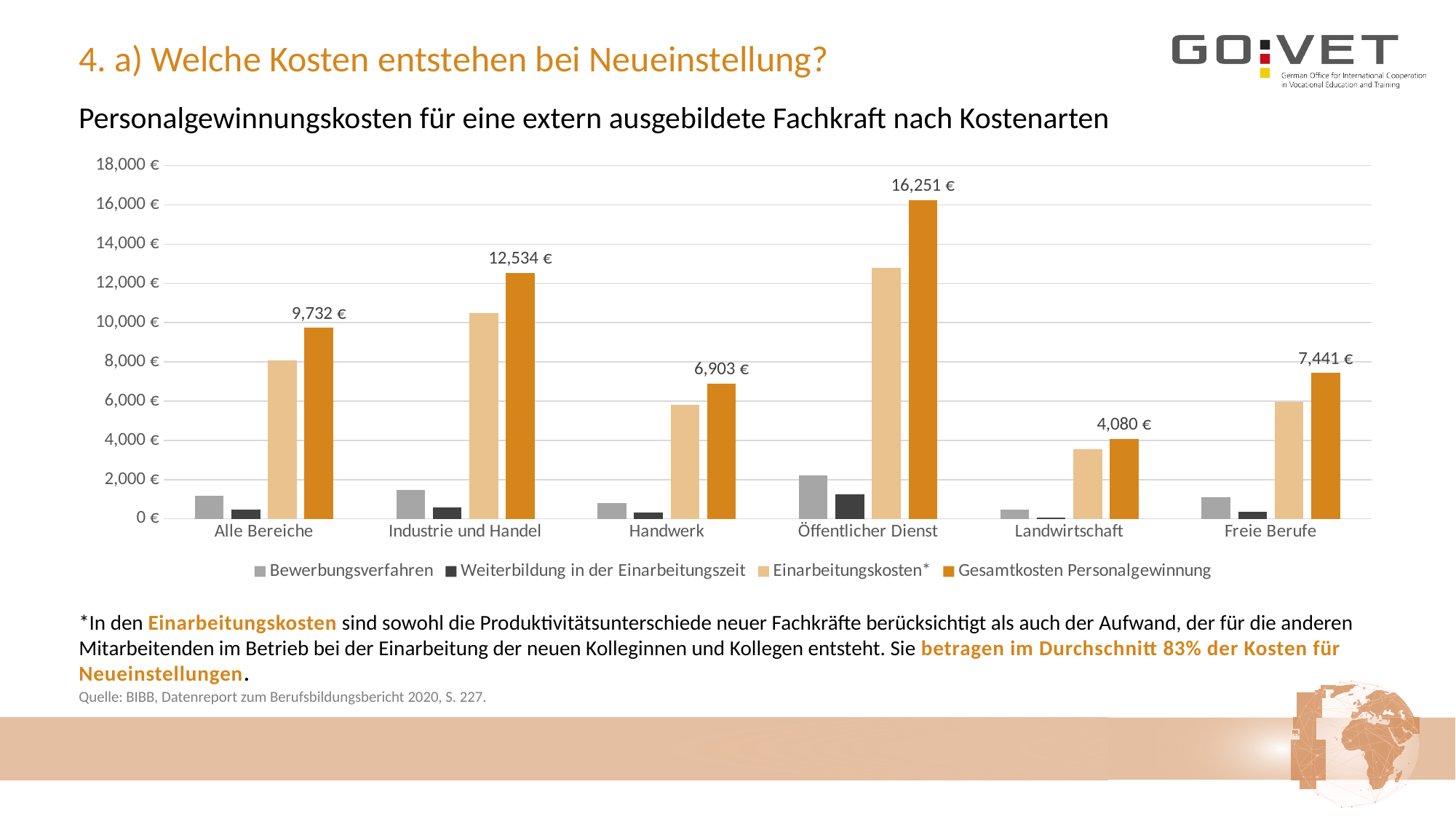
Is the Einarbeitungskosten value for Öffentlicher Dienst greater or less than 12,000 €? greater Which category has the lowest Gesamtkosten Personalgewinnung? Landwirtschaft Which category has the highest Gesamtkosten Personalgewinnung? Öffentlicher Dienst What kind of chart is shown on the slide? Bar chart Is the Bewerbungsverfahren value for Industrie und Handel greater or less than 2,000 €? less How many series does the legend list? 4 What is the Gesamtkosten Personalgewinnung value for Öffentlicher Dienst? 16,251 € Which has the larger Gesamtkosten Personalgewinnung, Freie Berufe or Handwerk? Freie Berufe How many categories are shown on the x axis? 6 What is the Gesamtkosten Personalgewinnung value for Alle Bereiche? 9,732 € What is the difference in Gesamtkosten Personalgewinnung between Industrie und Handel and Handwerk? 5,631 € What is the Gesamtkosten Personalgewinnung value for Landwirtschaft? 4,080 €